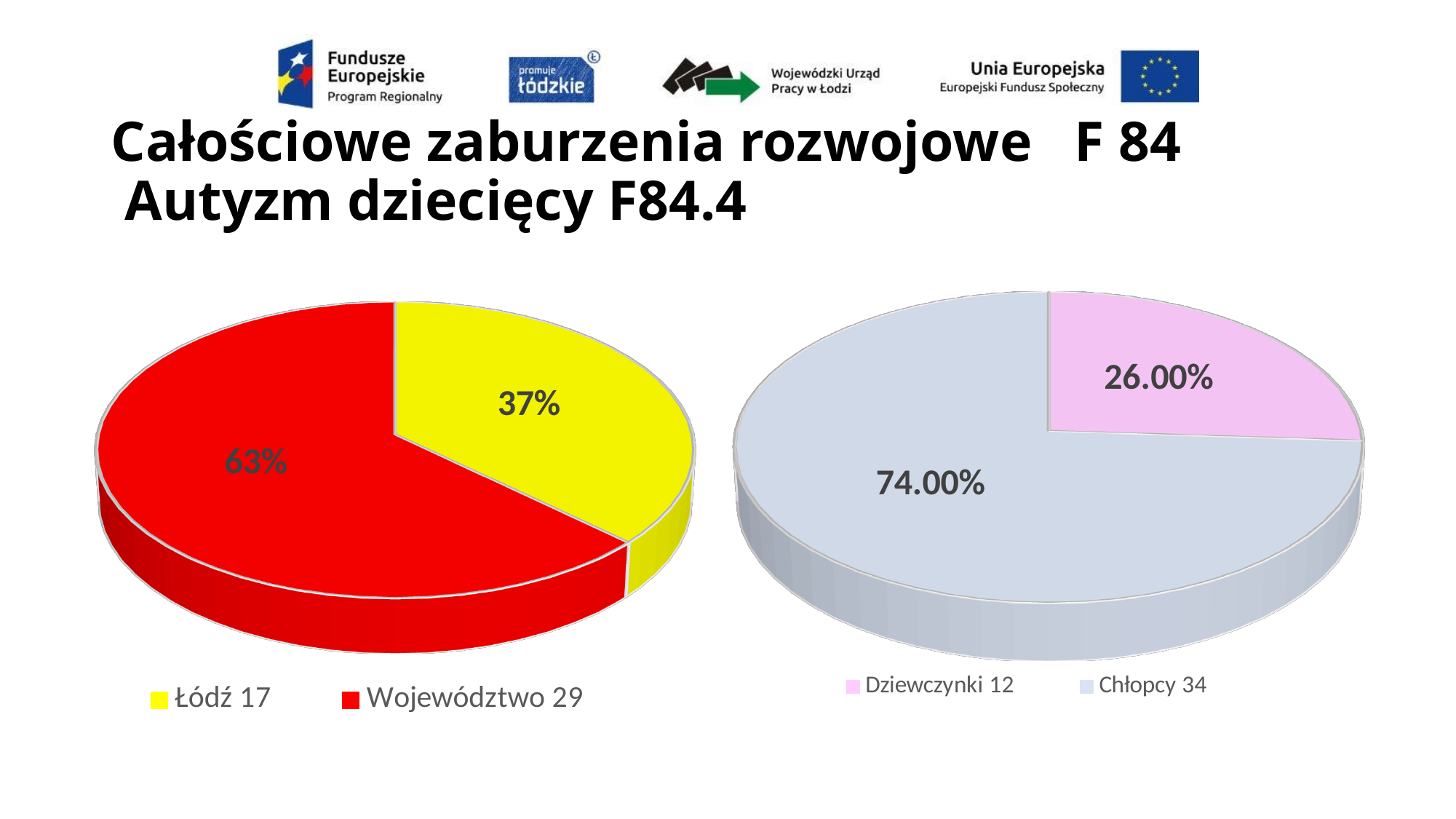
In the left pie chart, what value does the legend give for Łódź? 17 In the left pie chart, which slice is larger, Łódź or Województwo? Województwo In the left pie chart, what percentage share is shown for the Łódź slice? 37% In the left pie chart, what percentage share is shown for the Województwo slice? 63% In the right pie chart, which slice is the largest? Chłopcy In the right pie chart, what percentage share is shown for Dziewczynki? 26.00% In the left pie chart, what value does the legend give for Województwo? 29 In the right pie chart, what value does the legend give for Chłopcy? 34 What type of chart is the left chart on the slide? pie chart In the left pie chart, what is the difference between the Województwo value and the Łódź value? 12 How many slices does the right pie chart have? 2